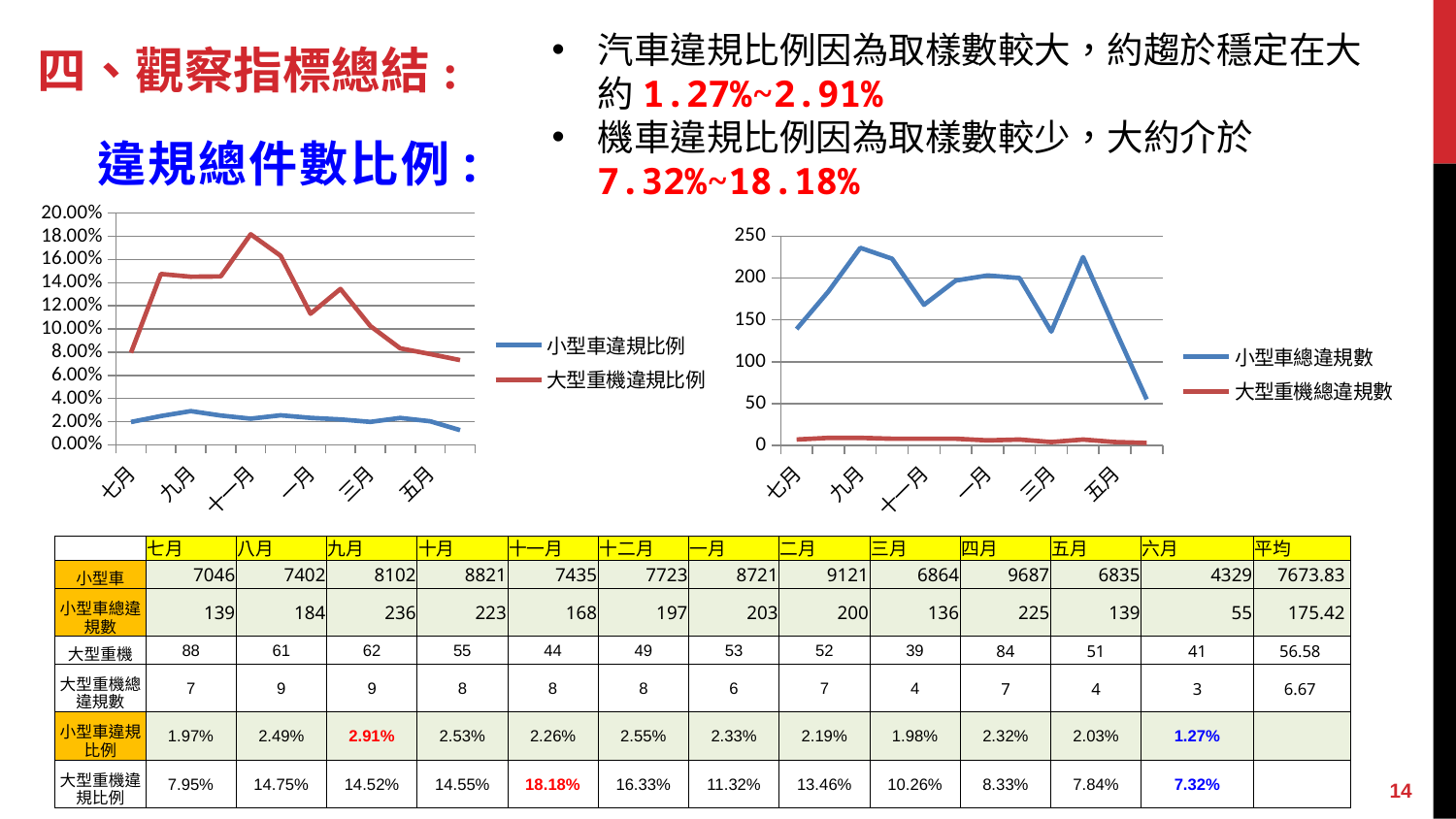
In the left chart, which series has the larger value in 十一月, 小型車違規比例 or 大型重機違規比例? 大型重機違規比例 How many series does the legend of the right chart list? 2 What is the difference between the highest 大型重機違規比例 (十一月, 18.18%) and the lowest (六月, 7.32%) shown on the slide? 10.86% In the right chart, which month has the lowest 小型車總違規數? 六月 In the left chart, is the value of 大型重機違規比例 for 十一月 greater or less than 16.00%? greater In the right chart, which month has the highest 小型車總違規數? 九月 In the left chart, which month has the lowest 大型重機違規比例? 六月 In the right chart, is the value of 大型重機總違規數 for 九月 greater or less than 50? less In the right chart, is the value of 小型車總違規數 for 七月 greater or less than 150? less In the left chart, does 大型重機違規比例 rise or fall from 二月 to 六月? fall What kind of chart is the chart on the left of the slide? line chart In the left chart, which month has the highest 大型重機違規比例? 十一月